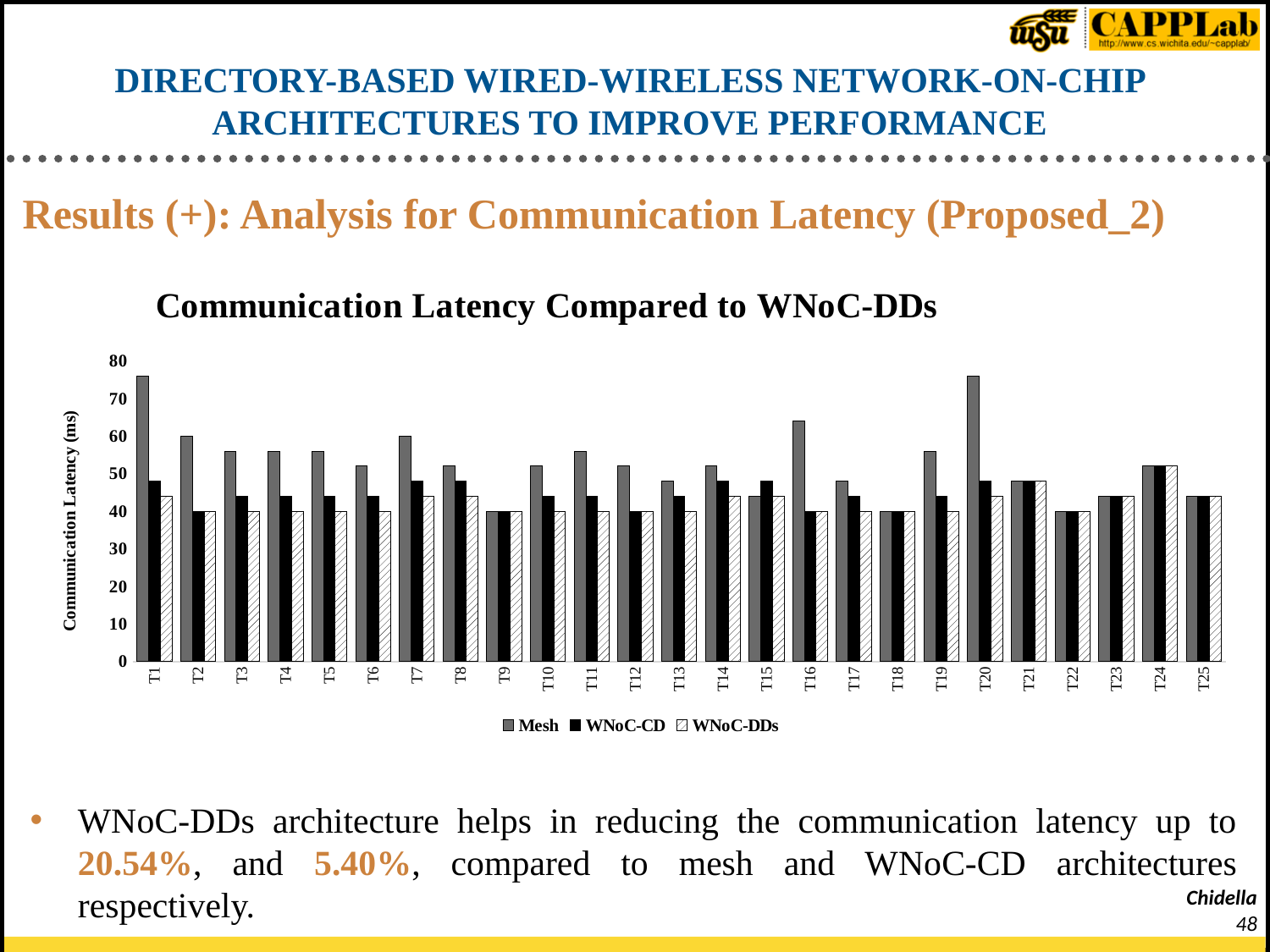
For T1, which series has the larger value, Mesh or WNoC-DDs? Mesh How many series does the legend of the chart list? 3 What kind of chart is shown on the slide? Bar chart Is the Mesh value for T16 greater or less than 60? greater Which series has the highest value for T1? Mesh How many categories (T1 to T25) are plotted along the x axis? 25 Which has the larger Mesh value, T22 or T24? T24 What is the title of the chart? Communication Latency Compared to WNoC-DDs What are the three series named in the chart legend? Mesh, WNoC-CD, WNoC-DDs Is the Mesh value for T1 greater or less than 70? greater What is the Mesh value for T2? 60 Is the Mesh value for T20 greater or less than 70? greater